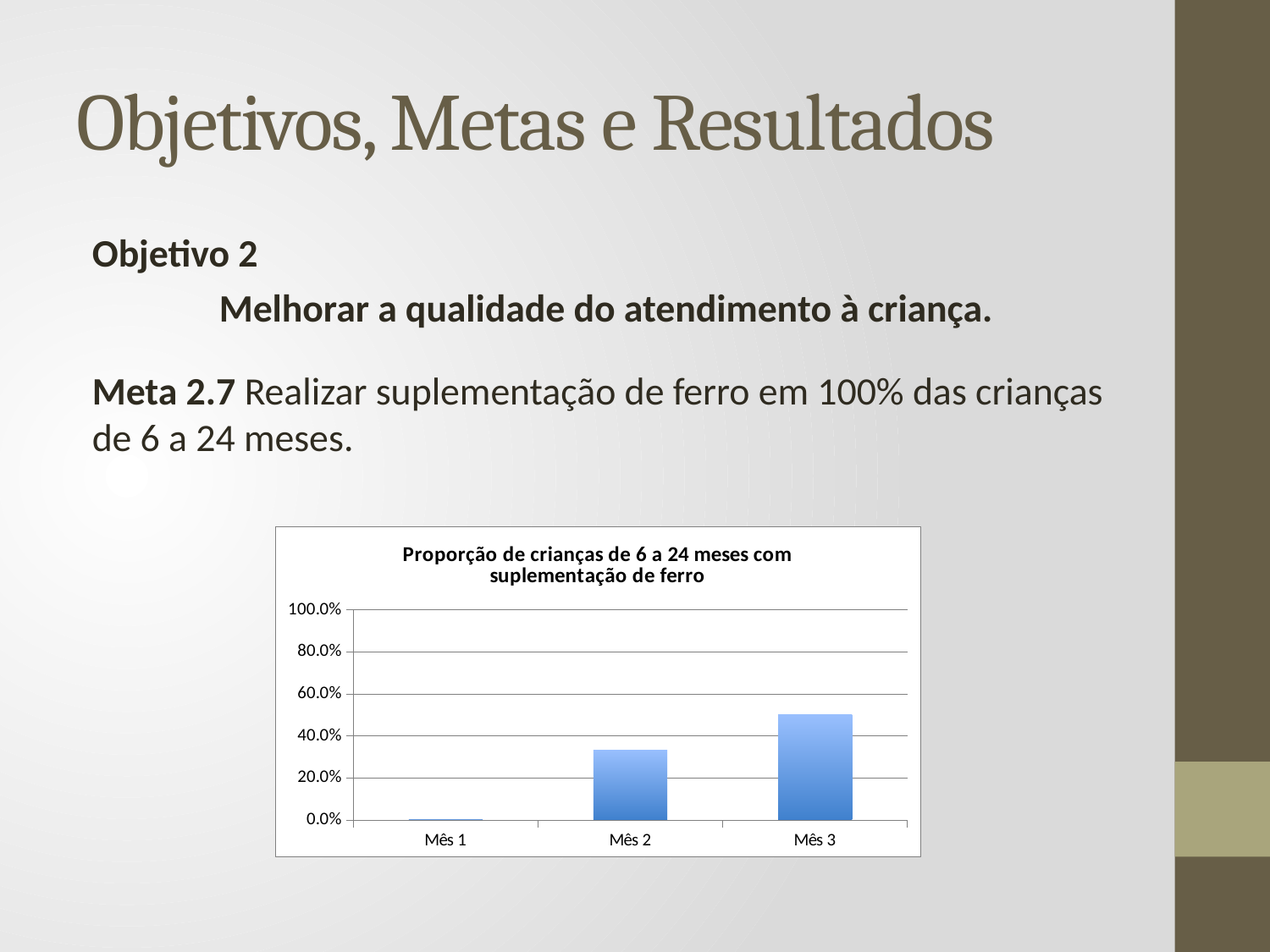
What is the title of the chart? Proporção de crianças de 6 a 24 meses com suplementação de ferro How many categories are shown on the x axis of the chart? 3 Do the values rise or fall from Mês 1 to Mês 3? rise Is the value for Mês 1 greater or less than 20.0%? less Is the value for Mês 3 greater or less than 60.0%? less Is the value for Mês 3 greater or less than 40.0%? greater What kind of chart is shown on the slide? bar chart Which month has the lowest proportion of children with iron supplementation? Mês 1 Which is larger, the value for Mês 2 or the value for Mês 3? Mês 3 Which month has the highest proportion of children with iron supplementation? Mês 3